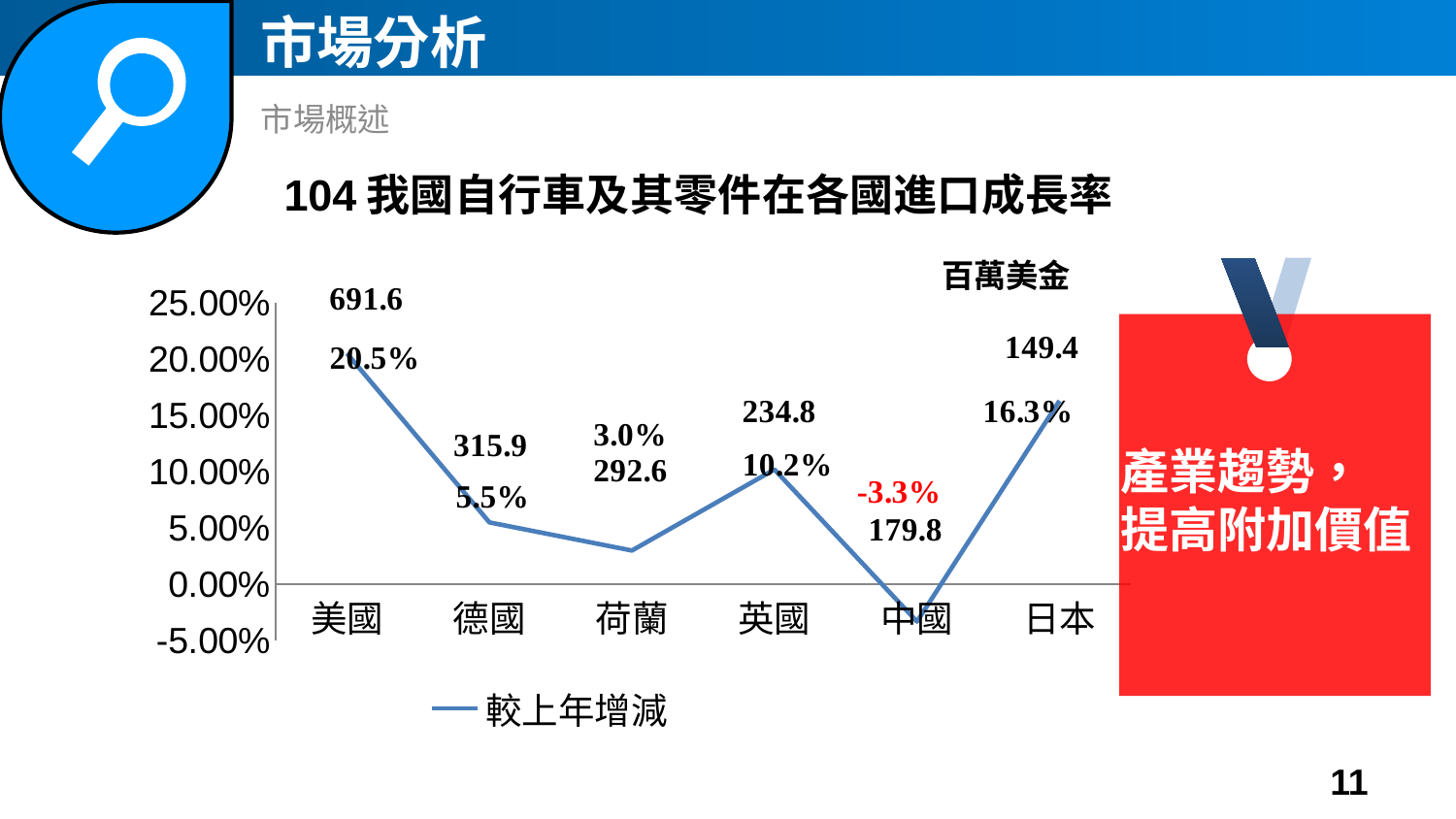
What import value in 百萬美金 is labelled for 德國? 315.9 Is the growth rate for 荷蘭 greater or less than 5.00%? less What is the growth rate shown for 日本? 16.3% Which country has the highest growth rate on the chart? 美國 Which has a higher growth rate, 英國 or 德國? 英國 How many countries are plotted on the chart? 6 What is the growth rate shown for 中國? -3.3% What type of chart is shown on the slide? line chart Which country has the lowest growth rate on the chart? 中國 What is the growth rate (較上年增減) shown for 美國? 20.5% What is the legend entry for the plotted series? 較上年增減 What is the difference between the growth rates of 美國 and 日本? 4.2%